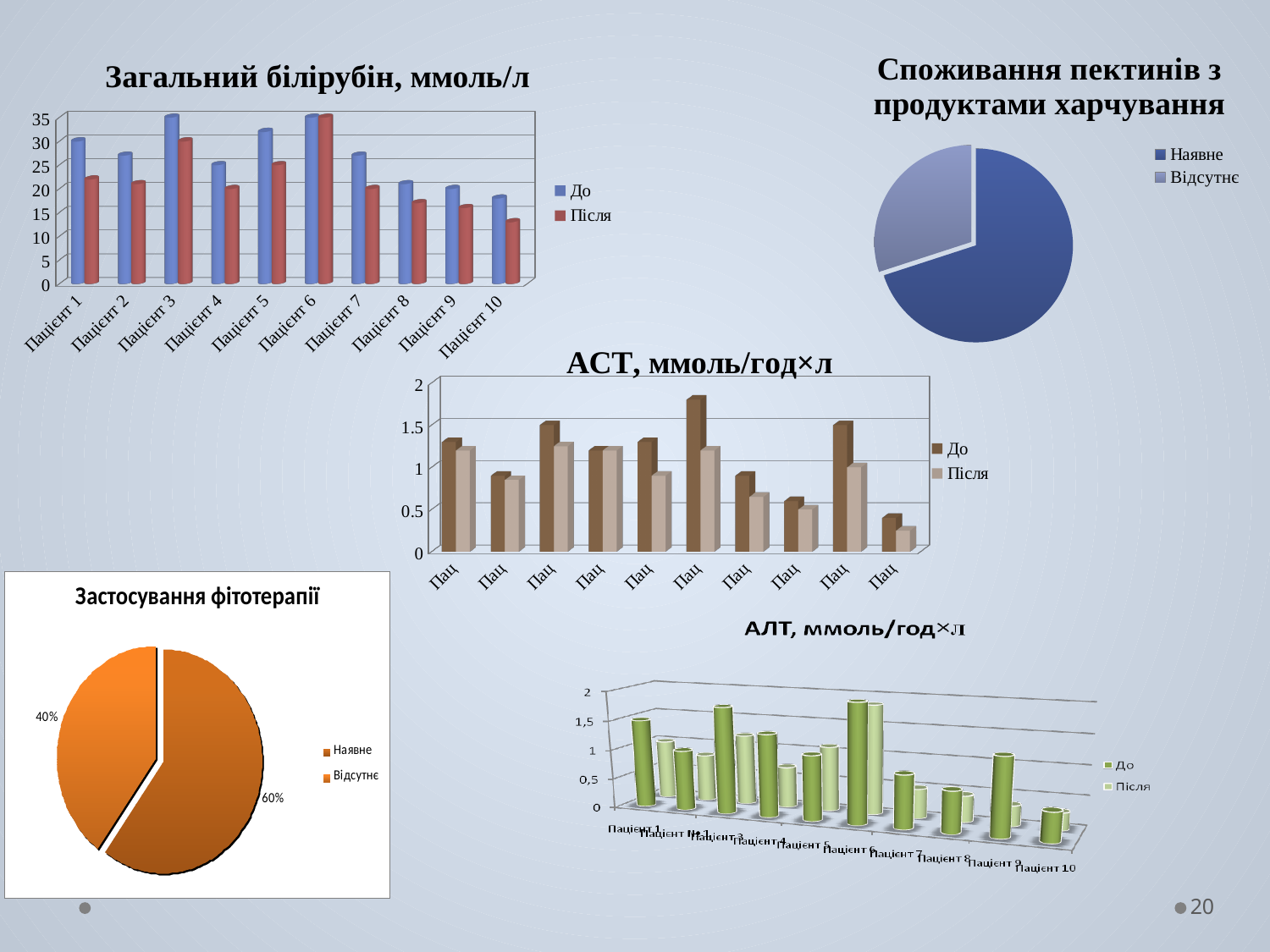
What kind of chart is 'Загальний білірубін, ммоль/л'? bar chart In the 'Загальний білірубін, ммоль/л' chart, is the 'Після' value for Пацієнт 10 greater or less than 15? less In the 'Застосування фітотерапії' pie chart, what share does 'Наявне' have? 60% In the 'Споживання пектинів з продуктами харчування' pie chart, which slice is larger: 'Наявне' or 'Відсутнє'? Наявне How many series does the legend of the 'АЛТ, ммоль/год×л' chart list? 2 In the 'Загальний білірубін, ммоль/л' chart, is the 'До' value for Пацієнт 1 greater or less than 25? greater In the 'АСТ, ммоль/год×л' chart, which patient has the highest 'До' value? Пацієнт 6 In the 'Загальний білірубін, ммоль/л' chart, which is larger for Пацієнт 1: 'До' or 'Після'? До In the 'АСТ, ммоль/год×л' chart, is the 'До' value for the sixth patient greater or less than 1.5? greater In the 'Застосування фітотерапії' pie chart, what share does 'Відсутнє' have? 40% In the 'Загальний білірубін, ммоль/л' chart, which patient has the lowest 'До' value? Пацієнт 10 In the 'Загальний білірубін, ммоль/л' chart, how many patients are shown on the x axis? 10